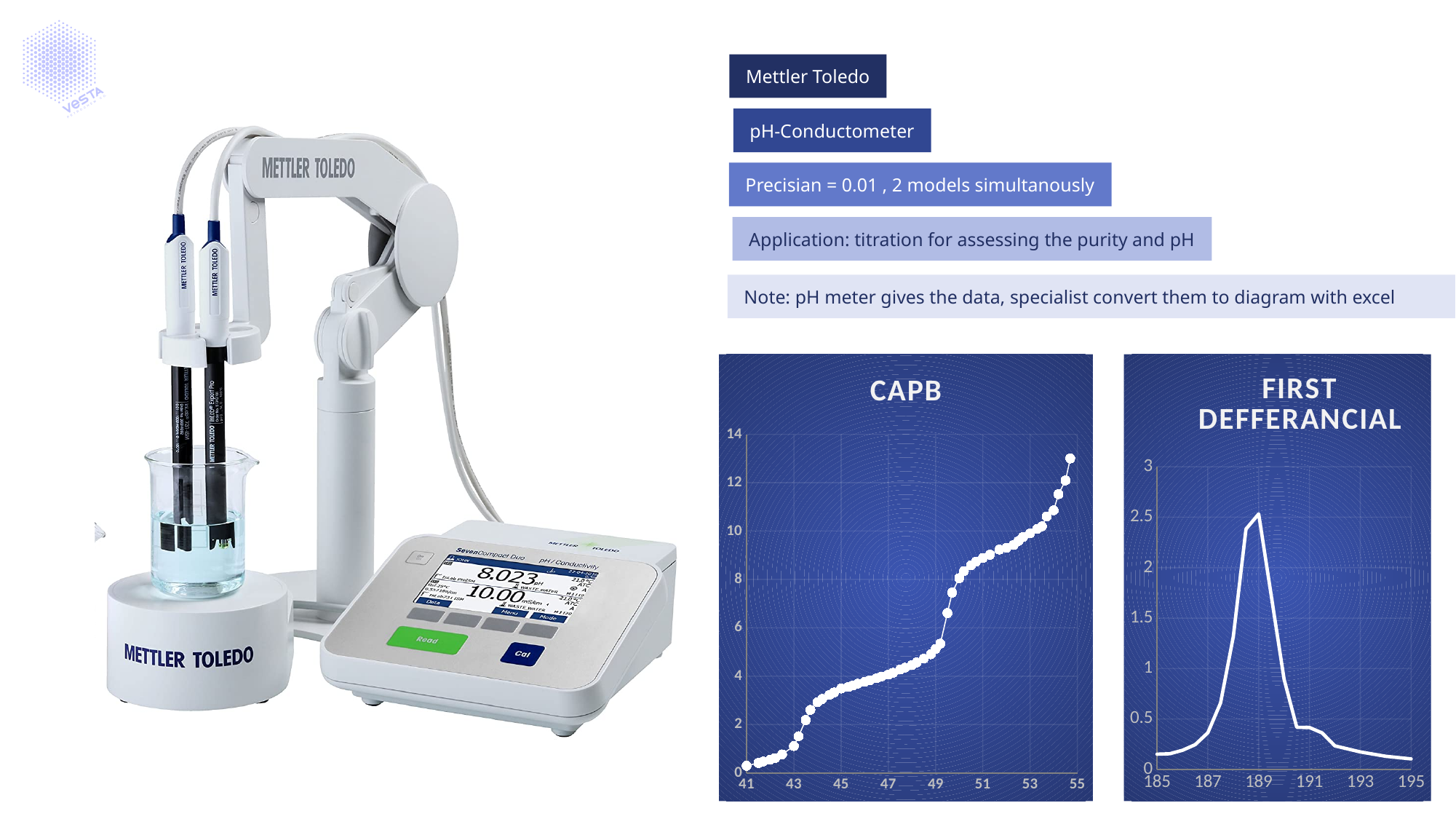
In the CAPB chart, do the values rise or fall as the x-axis value increases from 41 to 55? rise What kind of chart is the FIRST DEFFERANCIAL chart? line chart In the CAPB chart, is the value at x = 53 greater or less than 8? greater In the FIRST DEFFERANCIAL chart, is the peak value greater or less than 2? greater In the CAPB chart, is the value at x = 45 greater or less than 4? less What is the highest tick value shown on the y-axis of the CAPB chart? 14 What kind of chart is the CAPB chart? line chart What is the title of the chart on the far right of the slide? FIRST DEFFERANCIAL